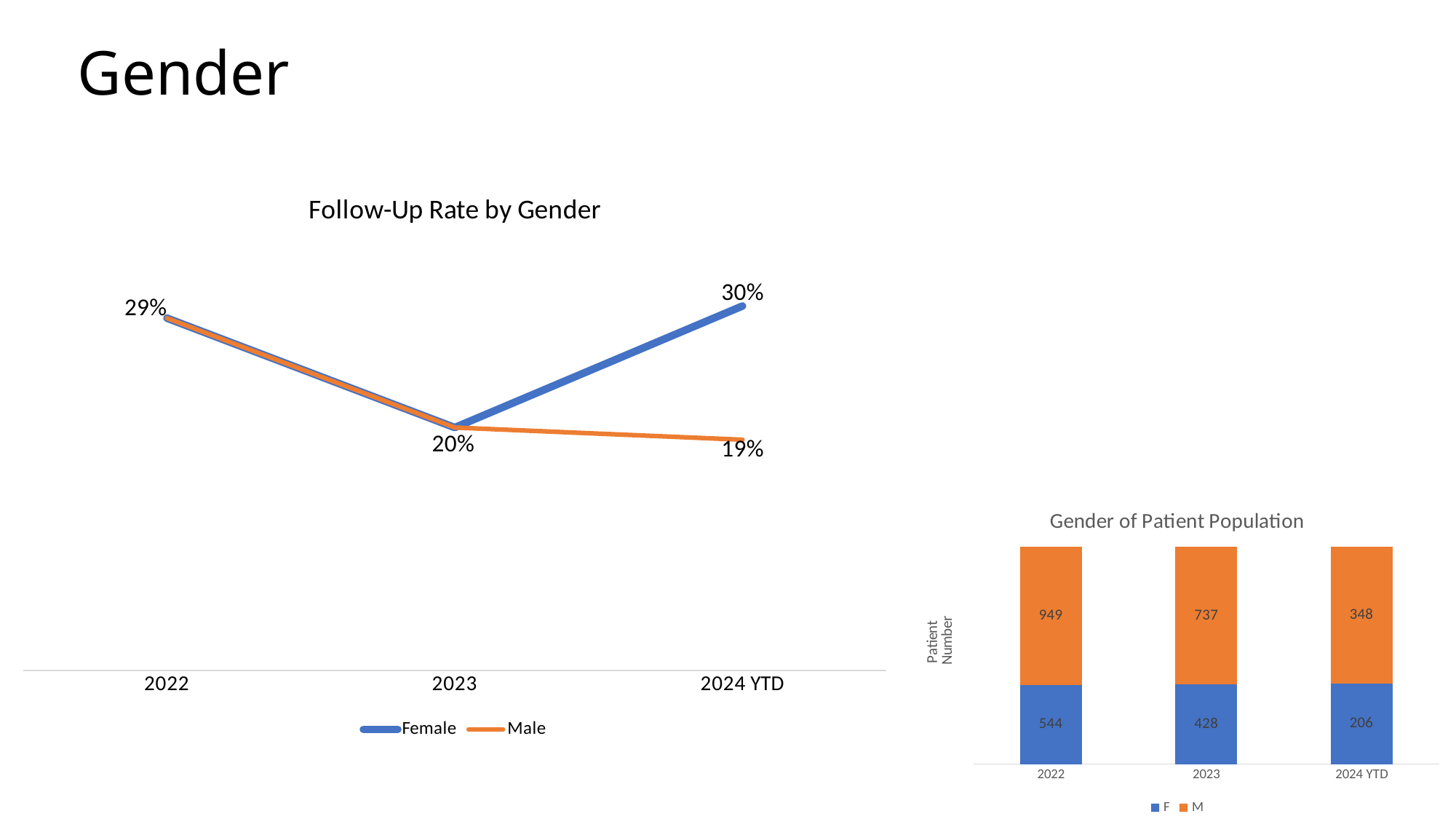
What kind of chart is the Follow-Up Rate by Gender chart? line chart In the Follow-Up Rate by Gender chart, what is the difference between the Female and Male rates in 2024 YTD? 11% In the Gender of Patient Population chart, what is the difference between the M and F values in 2022? 405 In the Gender of Patient Population chart, what is the M value for 2022? 949 In the Follow-Up Rate by Gender chart, does the Male rate rise or fall from 2022 to 2024 YTD? fall In the Follow-Up Rate by Gender chart, what is the Male follow-up rate for 2024 YTD? 19% In the Follow-Up Rate by Gender chart, how many series does the legend list? 2 In the Gender of Patient Population chart, what is the F value for 2024 YTD? 206 In the Follow-Up Rate by Gender chart, what is the Female follow-up rate for 2024 YTD? 30% In the Gender of Patient Population chart, what is the total of the 2023 bar? 1165 In the Gender of Patient Population chart, how many categories are shown on the x axis? 3 In the Follow-Up Rate by Gender chart, which series has the higher rate in 2024 YTD, Female or Male? Female